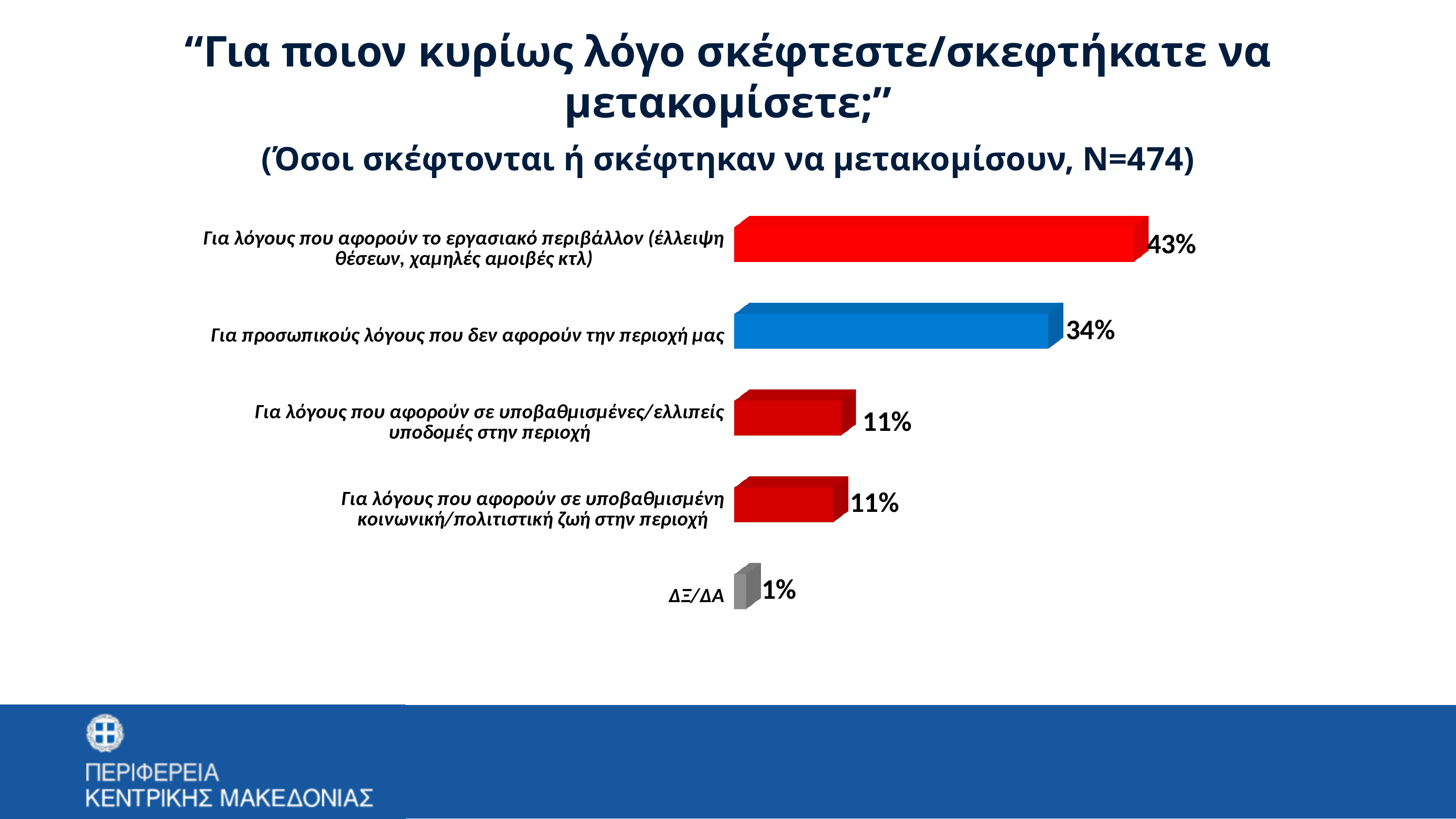
What is the difference between the value for "Για λόγους που αφορούν το εργασιακό περιβάλλον" and the value for "Για προσωπικούς λόγους που δεν αφορούν την περιοχή μας"? 9% What kind of chart is shown on the slide? Bar chart What percentage is shown for "Για λόγους που αφορούν το εργασιακό περιβάλλον (έλλειψη θέσεων, χαμηλές αμοιβές κτλ)"? 43% What percentage is shown for "Για προσωπικούς λόγους που δεν αφορούν την περιοχή μας"? 34% What percentage is shown for "Για λόγους που αφορούν σε υποβαθμισμένες/ελλιπείς υποδομές στην περιοχή"? 11% Which category has the lowest value? ΔΞ/ΔΑ What is the difference between the value for "Για προσωπικούς λόγους που δεν αφορούν την περιοχή μας" and the value for "Για λόγους που αφορούν σε υποβαθμισμένη κοινωνική/πολιτιστική ζωή στην περιοχή"? 23% What percentage is shown for "ΔΞ/ΔΑ"? 1% How many categories are shown in the chart? 5 Which is larger: the value for "Για προσωπικούς λόγους που δεν αφορούν την περιοχή μας" or the value for "Για λόγους που αφορούν σε υποβαθμισμένες/ελλιπείς υποδομές στην περιοχή"? Για προσωπικούς λόγους που δεν αφορούν την περιοχή μας What colour is the bar for "Για προσωπικούς λόγους που δεν αφορούν την περιοχή μας"? Blue Which category has the highest value? Για λόγους που αφορούν το εργασιακό περιβάλλον (έλλειψη θέσεων, χαμηλές αμοιβές κτλ)